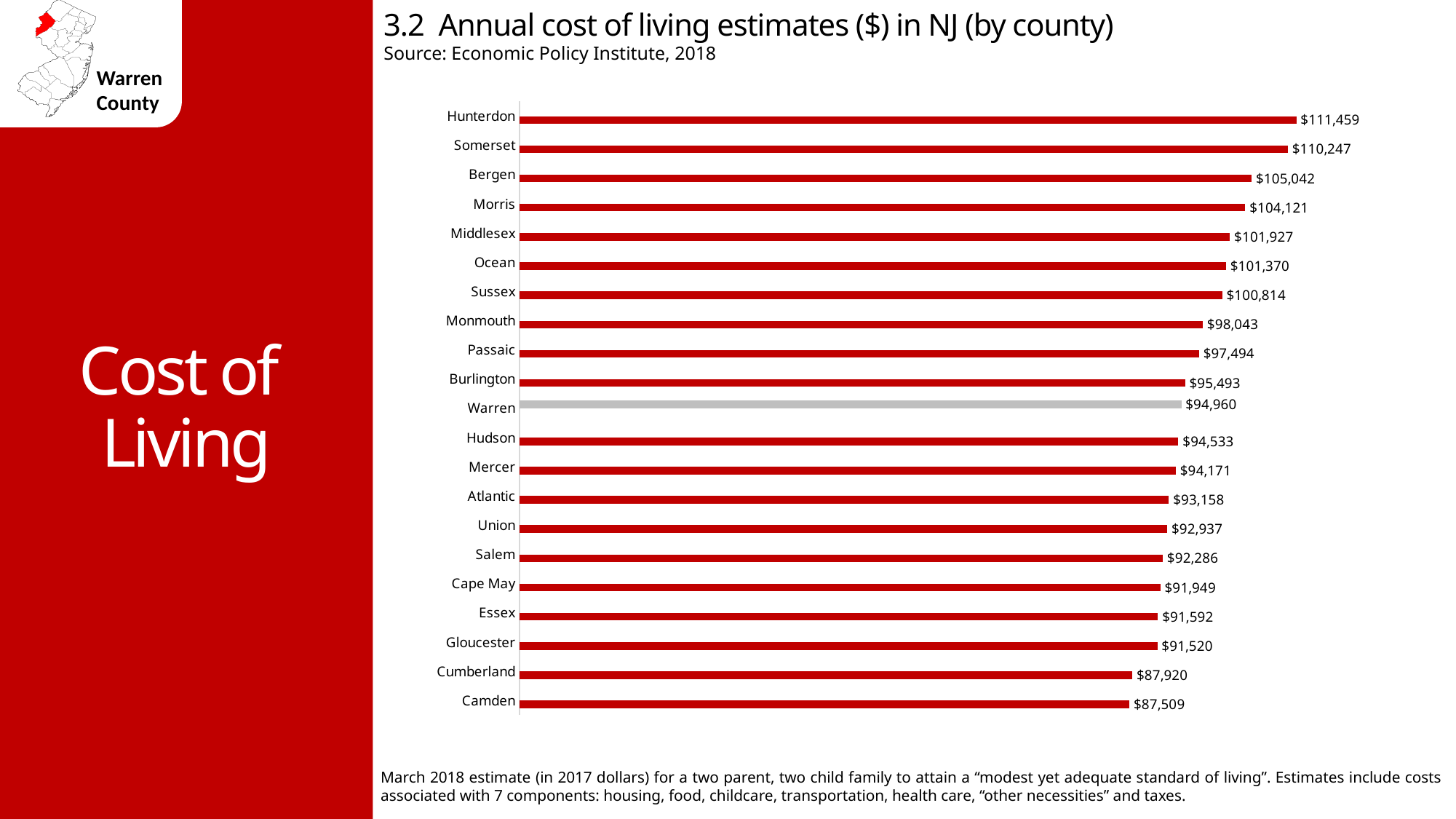
Which county has the lowest annual cost of living estimate? Camden Which county has a higher cost of living estimate, Cumberland or Gloucester? Gloucester What is the difference between the cost of living estimates for Warren and Hudson? $427 What is the difference between the cost of living estimates for Hunterdon and Camden? $23,950 What is the annual cost of living estimate for Warren County? $94,960 Which county has the highest annual cost of living estimate? Hunterdon Which county's bar is shown in grey rather than red? Warren Which county has a higher cost of living estimate, Sussex or Monmouth? Sussex What is the annual cost of living estimate for Morris County? $104,121 What is the annual cost of living estimate for Cape May County? $91,949 How many counties are shown in the chart? 21 What kind of chart is shown on the slide? Bar chart